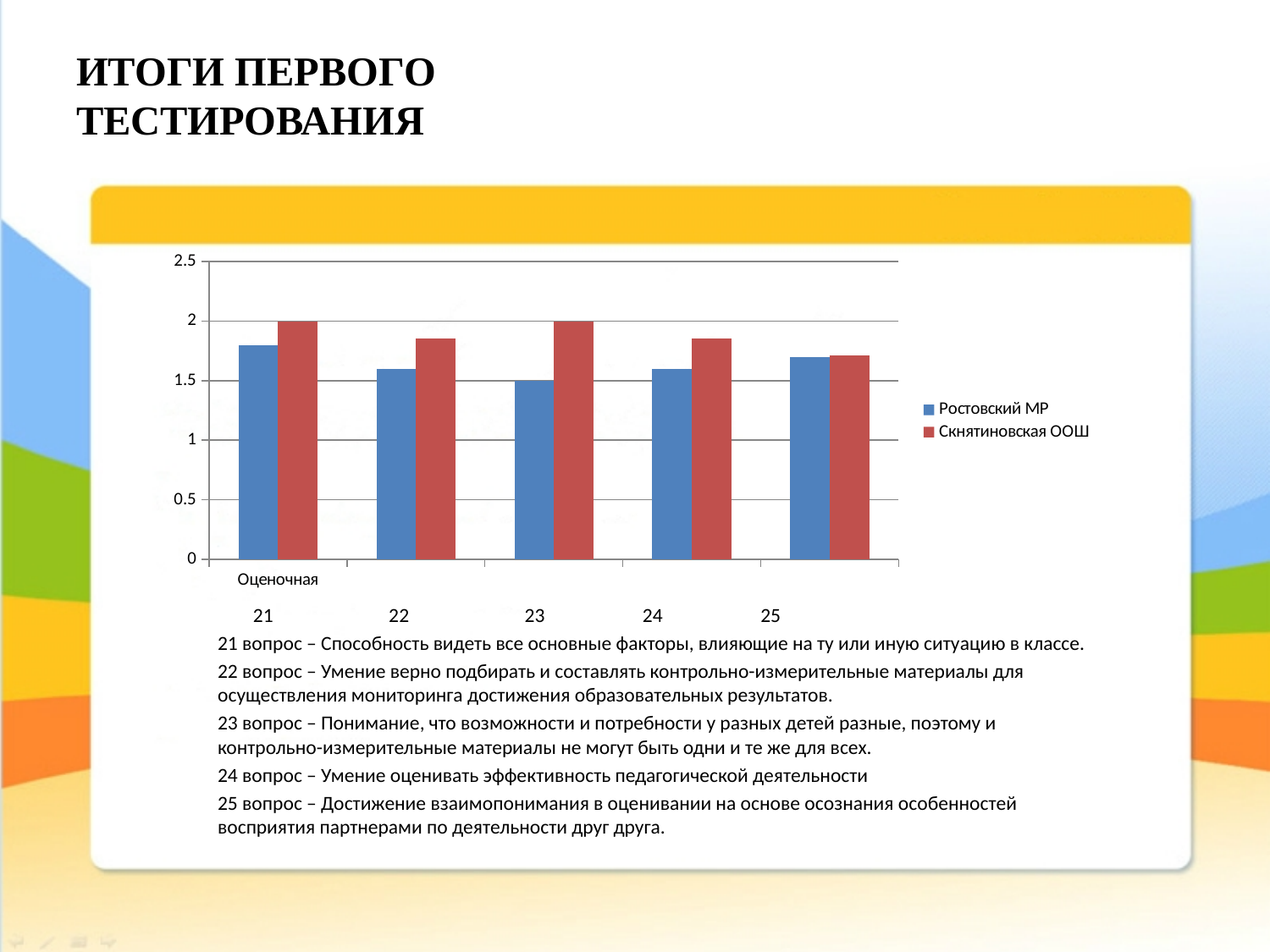
What kind of chart is shown on the slide? bar chart What is the value for Скнятиновская ООШ for question 23? 2 How many question categories (groups of bars) are plotted on the chart? 5 Is the value for Скнятиновская ООШ for question 22 greater or less than 2? less What is the value for Скнятиновская ООШ for question 21? 2 What is the value for Ростовский МР for question 23? 1.5 How many series does the chart legend list? 2 For question 23, which is larger: Ростовский МР or Скнятиновская ООШ? Скнятиновская ООШ Which colour represents Ростовский МР in the chart? blue Is the value for Ростовский МР for question 21 greater or less than 1.5? greater Is the value for Ростовский МР for question 24 greater or less than 2? less For which question is the Ростовский МР value lowest? 23